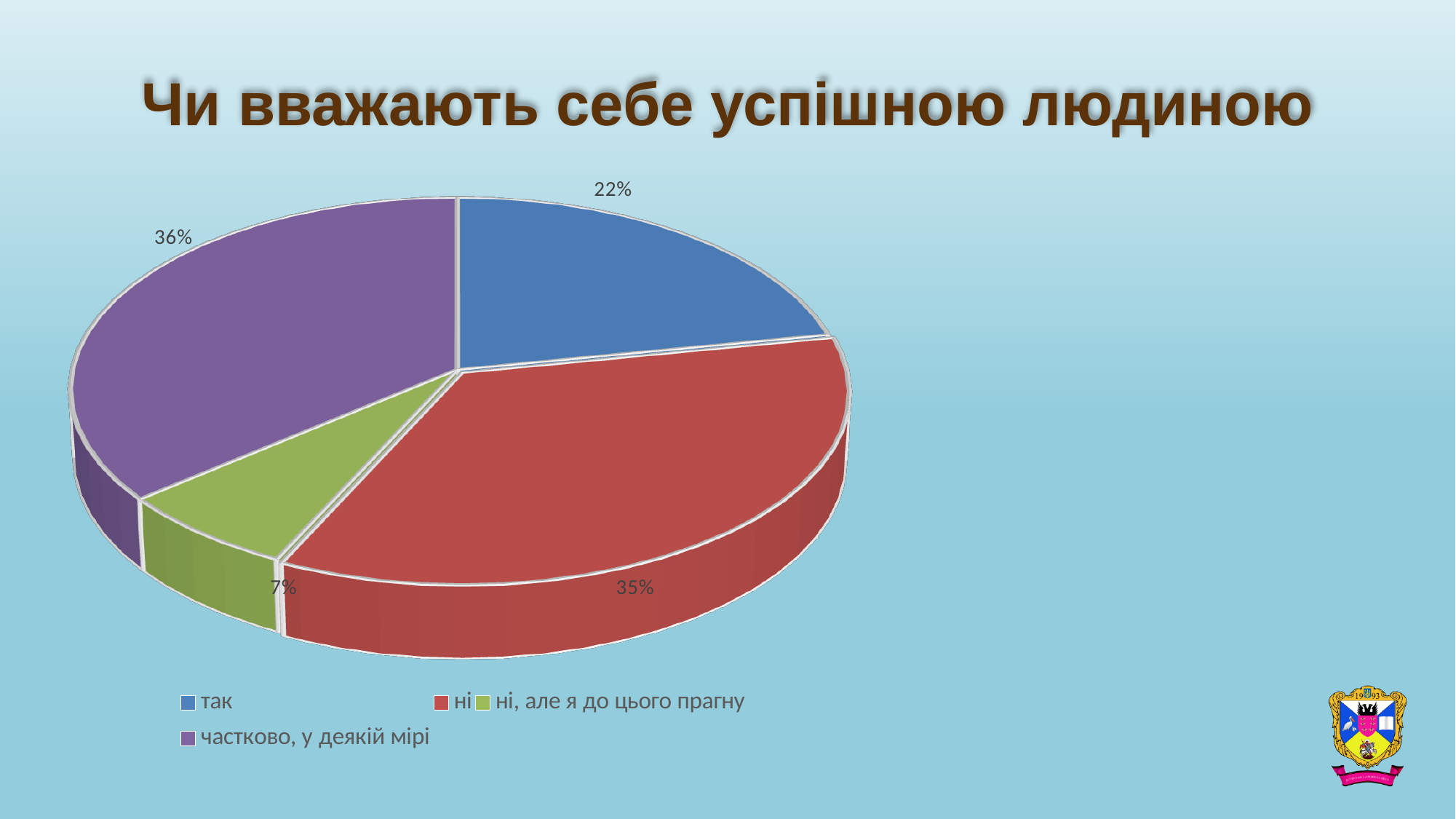
How many categories does the pie chart have? 4 Which slice is larger, "так" or "ні, але я до цього прагну"? так What is the title of the chart? Чи вважають себе успішною людиною What is the difference in percentage points between the "ні" slice and the "так" slice? 13 Which category has the largest slice of the pie? частково, у деякій мірі What percentage of the pie is the slice for "так"? 22% What percentage of the pie is the slice for "ні, але я до цього прагну"? 7% What kind of chart is shown on the slide? pie chart What percentage of the pie is the slice for "ні"? 35% Which category has the smallest slice of the pie? ні, але я до цього прагну What colour is the slice for "ні"? red What percentage of the pie is the slice for "частково, у деякій мірі"? 36%